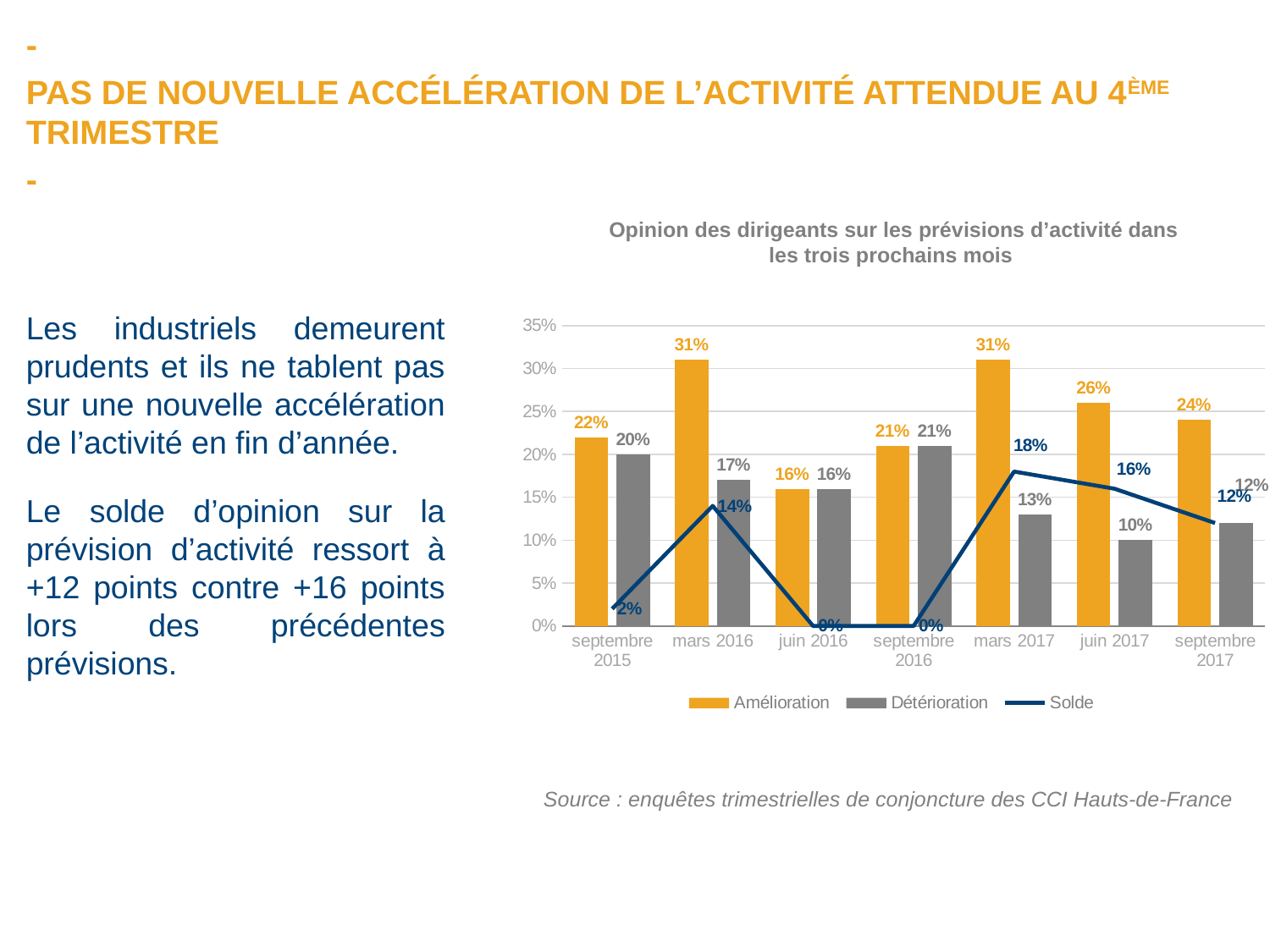
What is the Détérioration value for septembre 2015? 20% Which period has the lowest Détérioration value? juin 2017 What is the Solde value for juin 2017? 16% Which period has the lowest Amélioration value? juin 2016 What is the Amélioration value for mars 2017? 31% What is the difference between the Amélioration and Détérioration values for mars 2017? 18% Which period has the highest Solde value? mars 2017 Which period has the highest Détérioration value? septembre 2016 What is the Solde value for septembre 2017? 12% How many periods are shown on the x axis? 7 Which is larger for juin 2017, Amélioration or Détérioration? Amélioration How many series does the legend list? 3